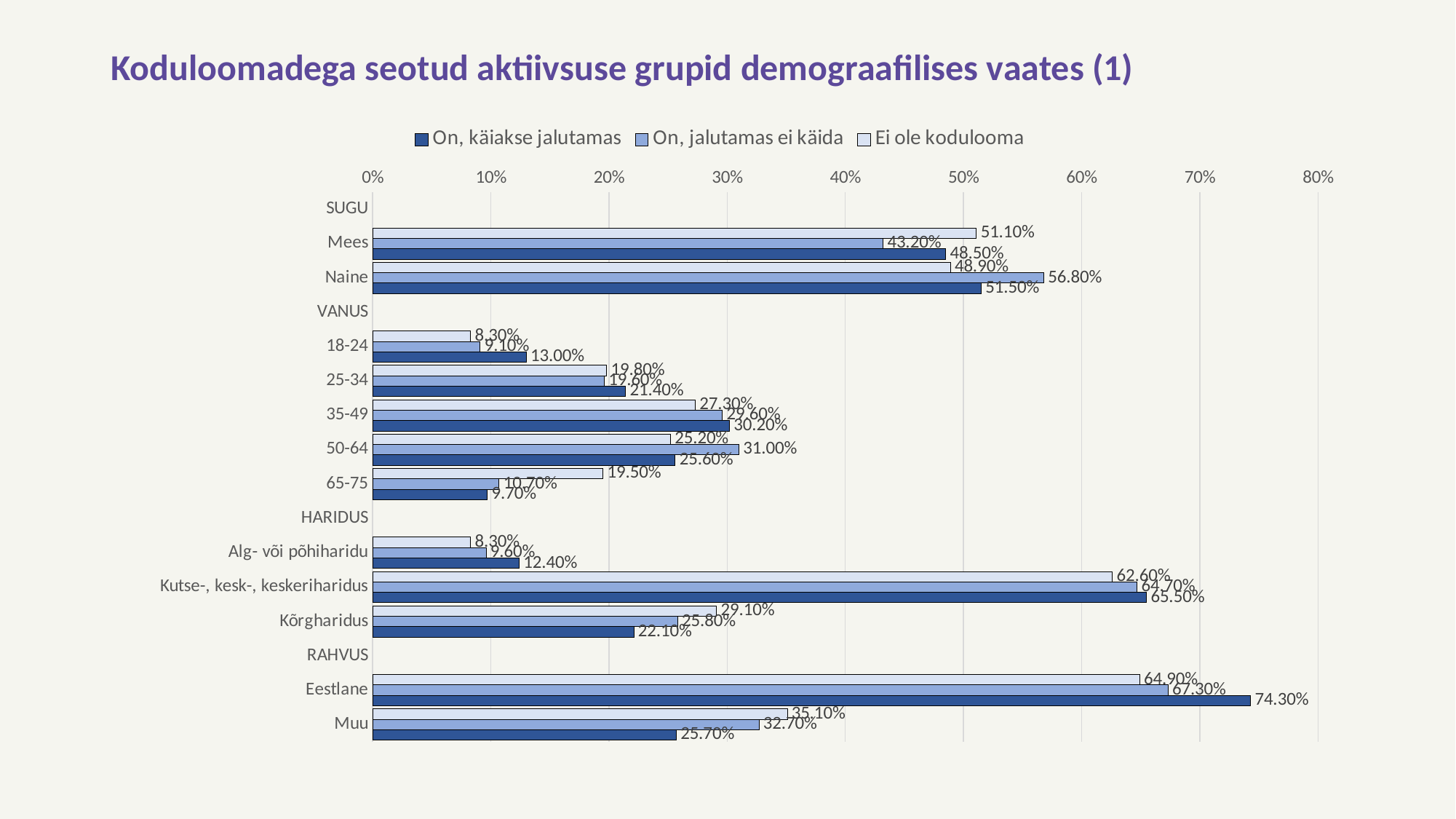
For Kõrgharidus, what is the difference between the "Ei ole kodulooma" value and the "On, käiakse jalutamas" value? 7.00 percentage points What is the difference between Eestlane and Muu in the "On, käiakse jalutamas" series? 48.60 percentage points What is the value for Mees in the "Ei ole kodulooma" series? 51.10% Which category has the lowest value in the "On, käiakse jalutamas" series? 65-75 How many series does the legend list? 3 What is the value for Eestlane in the "On, käiakse jalutamas" series? 74.30% In the "On, jalutamas ei käida" series, which is larger: Mees or Naine? Naine What is the title of the slide? Koduloomadega seotud aktiivsuse grupid demograafilises vaates (1) What is the value for 50-64 in the "On, jalutamas ei käida" series? 31.00% What is the value for Naine in the "On, jalutamas ei käida" series? 56.80% What kind of chart is shown on the slide? Bar chart Which category has the highest value in the "On, käiakse jalutamas" series? Eestlane